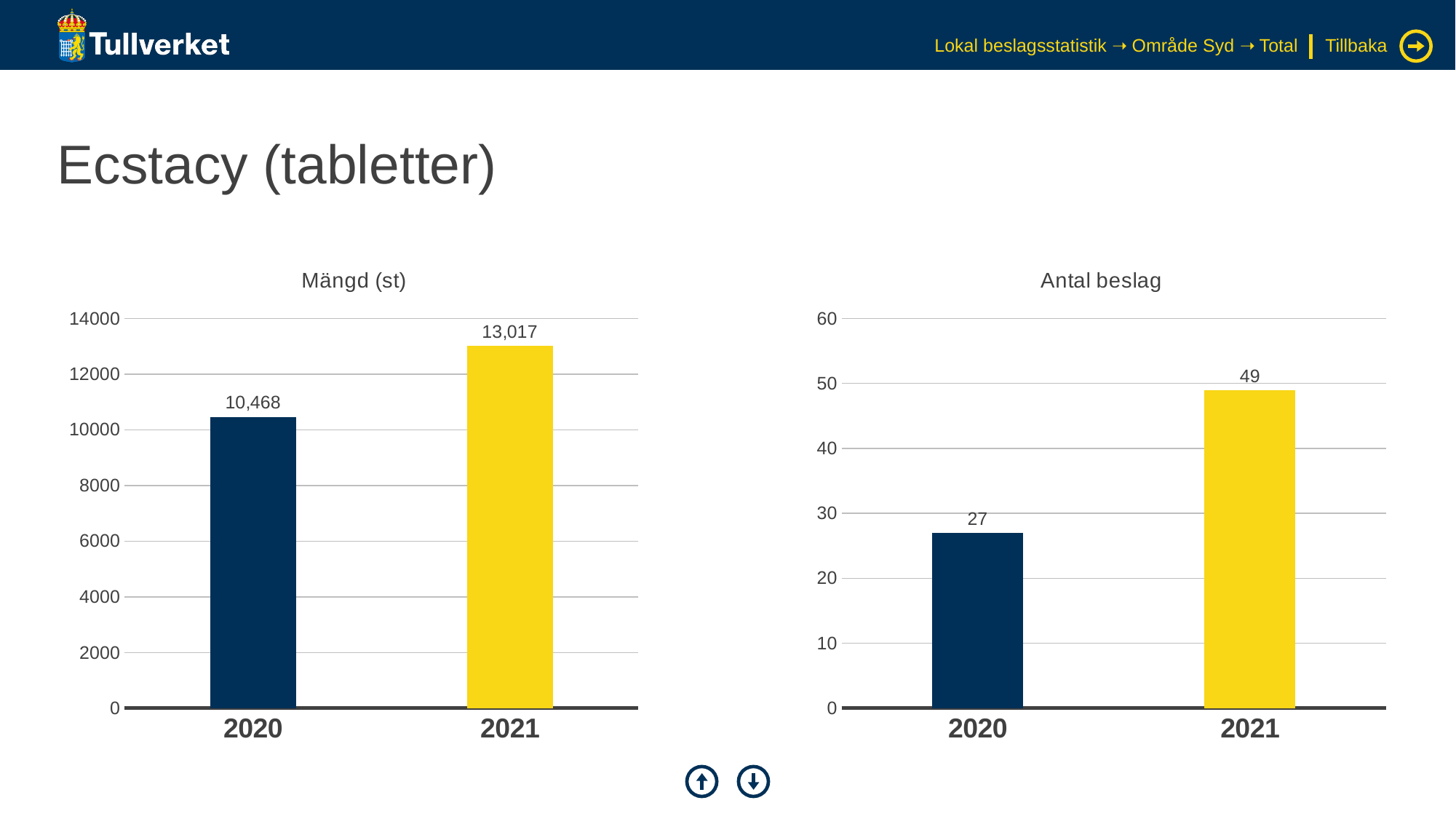
In the 'Antal beslag' chart, is the value for 2020 greater or less than 30? less In the 'Mängd (st)' chart, what is the difference between the 2021 and 2020 values? 2,549 In the 'Antal beslag' chart, which year has the lowest value? 2020 How many categories are shown in the 'Mängd (st)' chart? 2 In the 'Mängd (st)' chart, what is the value for 2021? 13,017 What kind of chart is the 'Antal beslag' chart? bar chart In the 'Mängd (st)' chart, do the values rise or fall from 2020 to 2021? rise In the 'Mängd (st)' chart, what is the value for 2020? 10,468 In the 'Antal beslag' chart, what is the value for 2021? 49 In the 'Antal beslag' chart, what is the difference between the 2021 and 2020 values? 22 In the 'Antal beslag' chart, what is the value for 2020? 27 In the 'Mängd (st)' chart, which year has the highest value? 2021